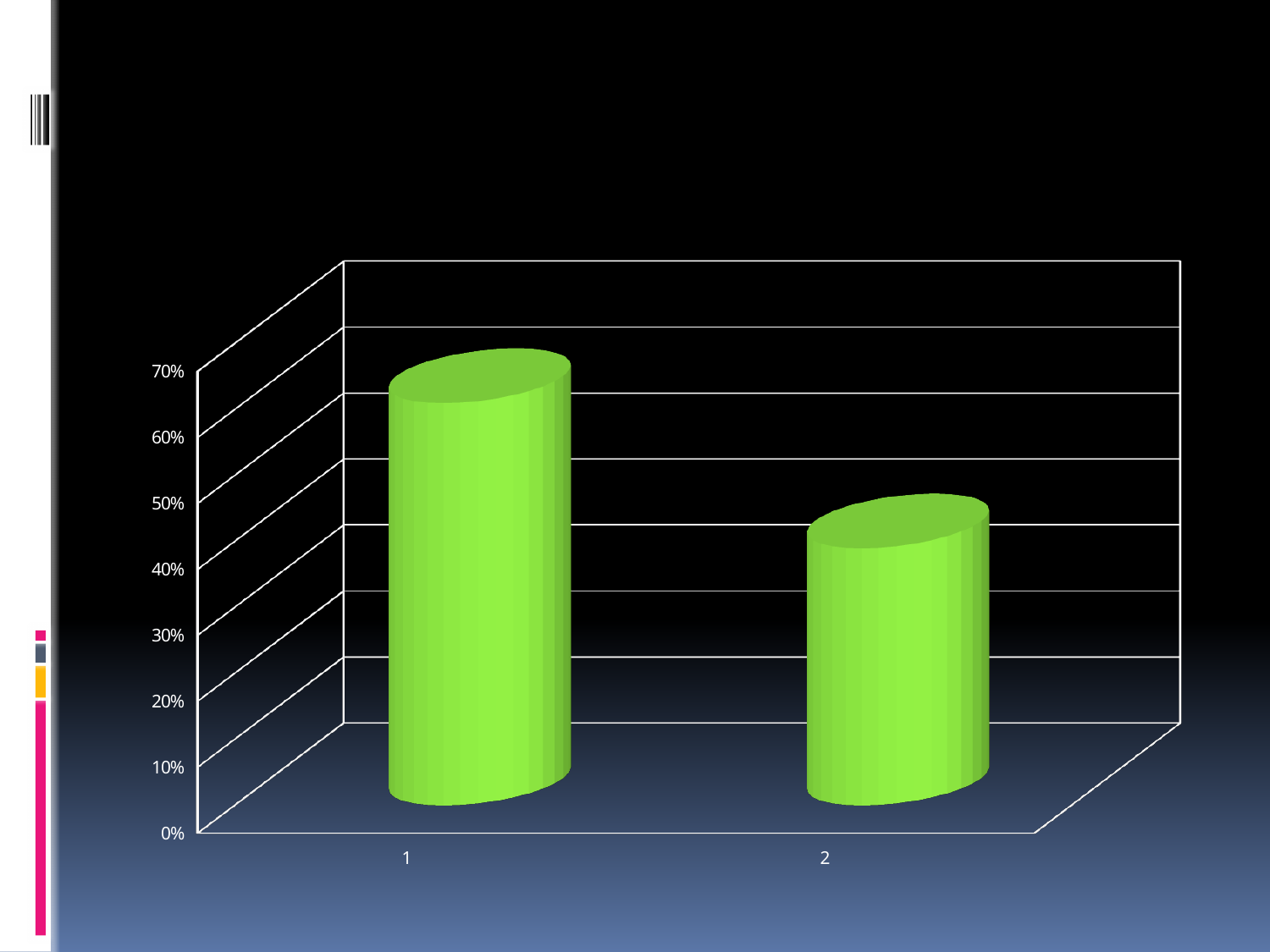
Is the value for category 2 greater or less than 50%? less Is the value for category 2 greater or less than 30%? greater What kind of chart is shown on the slide? bar chart Which category has the lowest value? 2 Which is larger, the value for category 1 or category 2? 1 How many categories are plotted on the x axis? 2 Is the value for category 1 greater or less than 50%? greater Which category has the highest value? 1 Do the values rise or fall from category 1 to category 2? fall What is the highest value shown on the vertical axis? 70% What colour are the bars in the chart? green